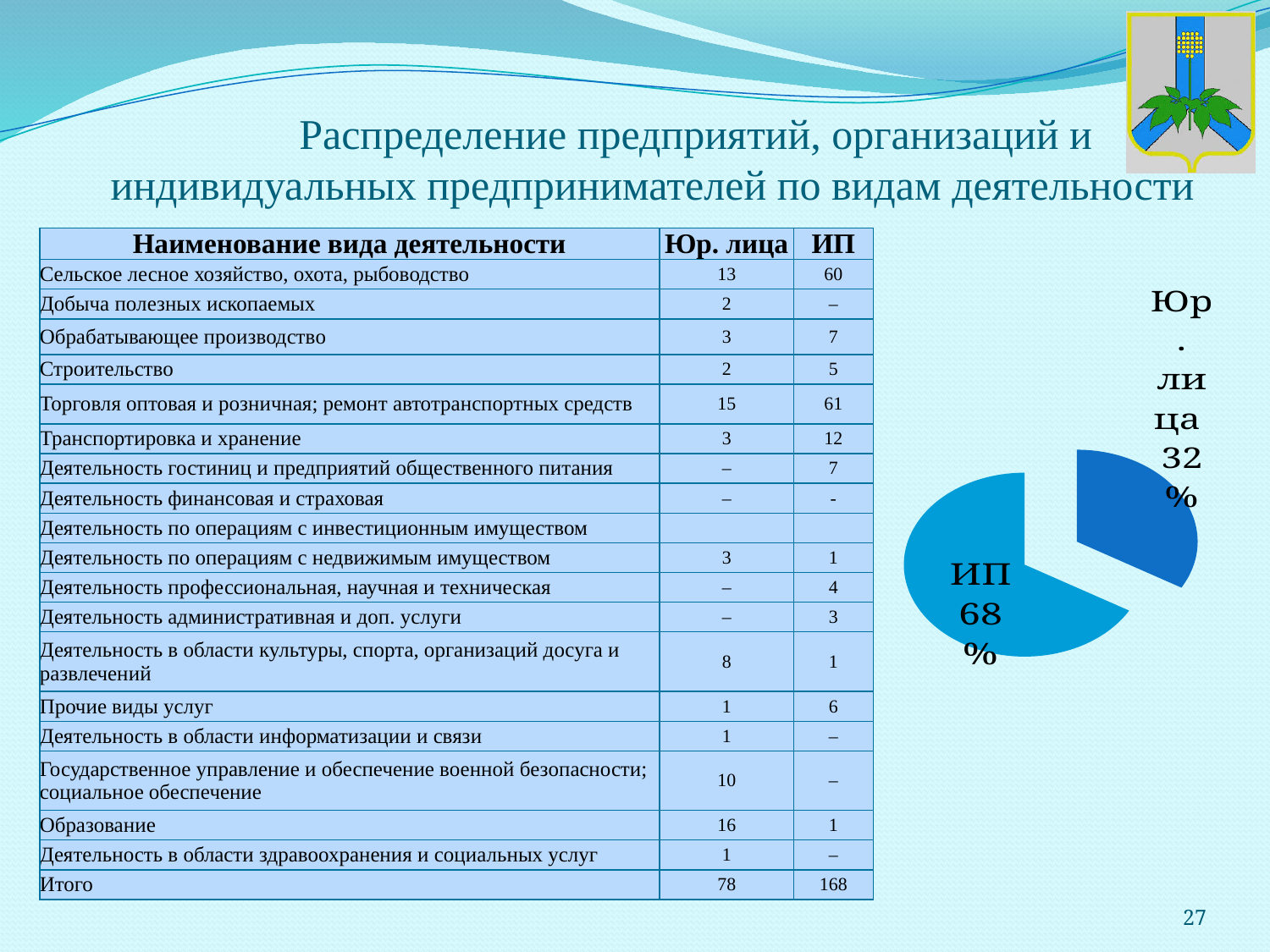
Which slice of the pie chart is pulled out (exploded) from the rest of the pie? Юр. лица Is the share for Юр. лица in the pie chart greater or less than 50%? less How many slices does the pie chart have? 2 What share of the pie chart does ИП account for? 68% Is the share for ИП in the pie chart greater or less than 50%? greater What kind of chart is shown on the right side of the slide? pie chart What share of the pie chart does Юр. лица account for? 32% What is the difference in percentage points between the ИП slice and the Юр. лица slice in the pie chart? 36 In the pie chart, which is larger: the share for ИП or the share for Юр. лица? ИП Which slice of the pie chart is the smallest? Юр. лица What are the labels of the two slices in the pie chart? Юр. лица and ИП Which slice of the pie chart is the largest? ИП